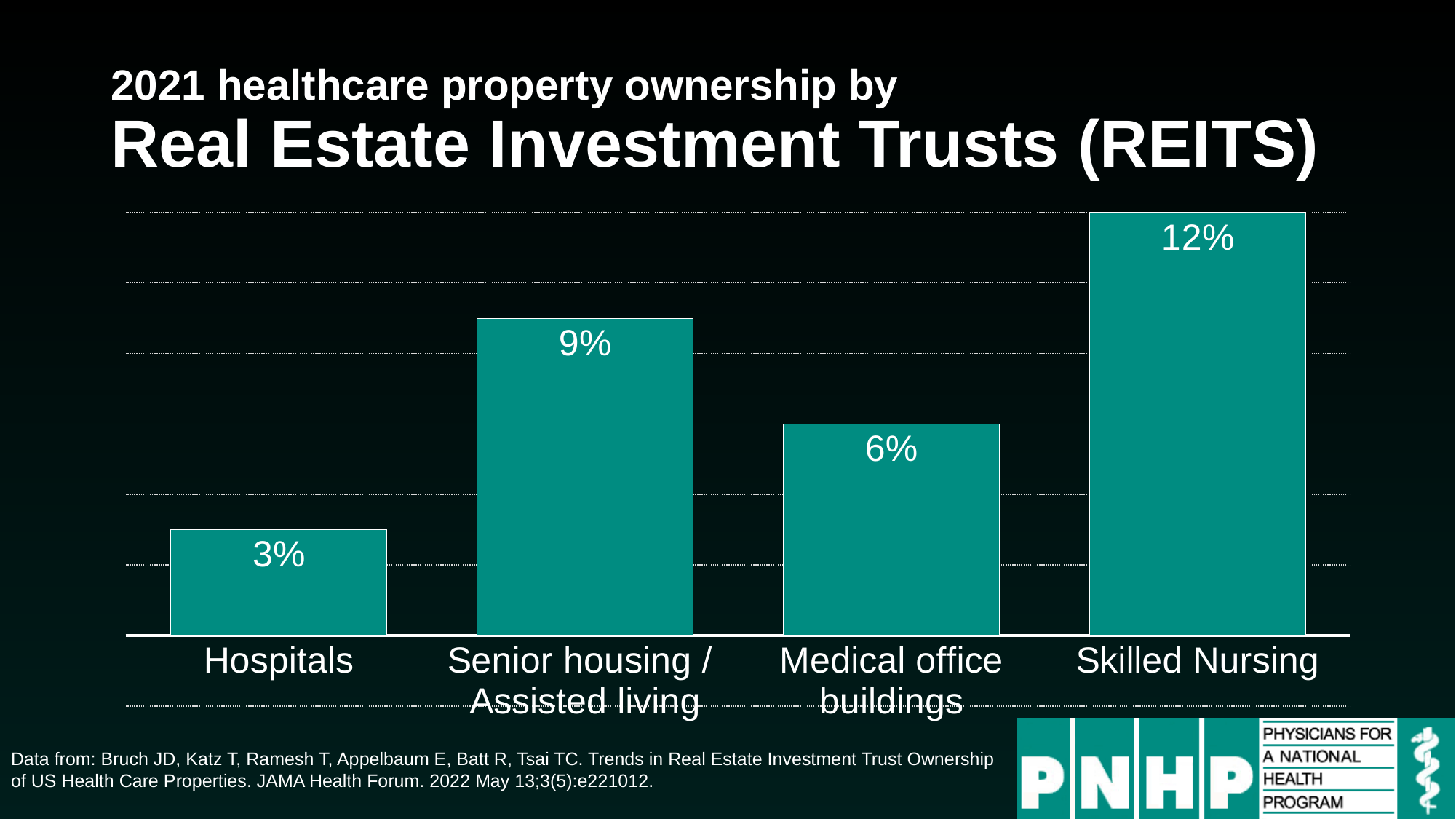
What is the value shown for Skilled Nursing? 12% What kind of chart is shown on the slide? Bar chart How many property categories are shown in the chart? 4 Which property category has the highest REIT ownership share? Skilled Nursing What is the value shown for Senior housing / Assisted living? 9% Which is larger, the value for Medical office buildings or the value for Senior housing / Assisted living? Senior housing / Assisted living What is the difference between the Skilled Nursing value and the Hospitals value? 9% What colour are the bars in the chart? Teal Which property category has the lowest REIT ownership share? Hospitals What is the value shown for Medical office buildings? 6% What is the difference between the Senior housing / Assisted living value and the Medical office buildings value? 3% What percentage of hospitals were owned by REITs in 2021 according to the chart? 3%